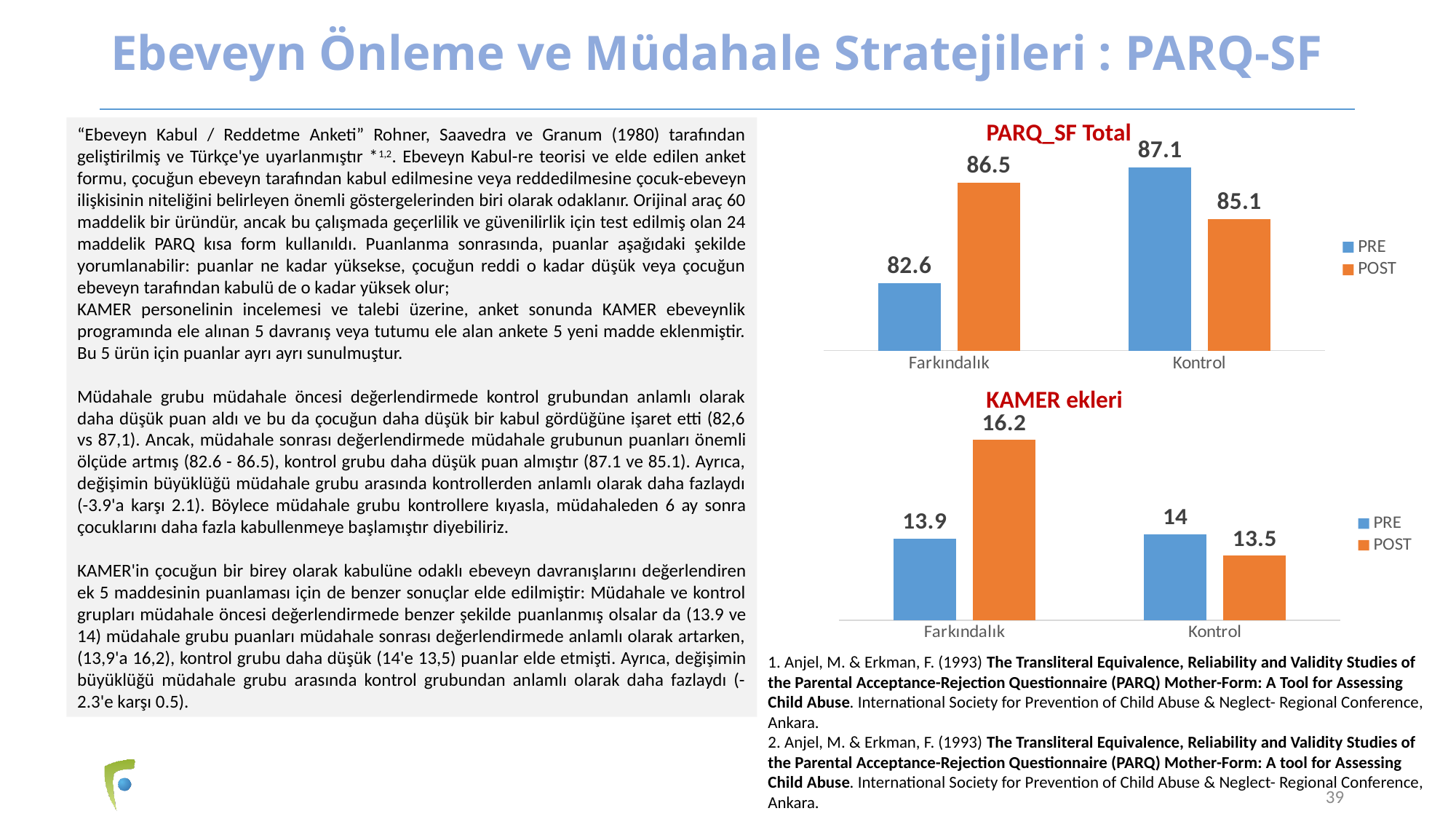
In the KAMER ekleri chart, what is the PRE value for Kontrol? 14 In the KAMER ekleri chart, what is the difference between the PRE and POST values for Kontrol? 0.5 How many categories are shown on the x axis of the PARQ_SF Total chart? 2 In the KAMER ekleri chart, what is the POST value for Farkındalık? 16.2 In the PARQ_SF Total chart, which bar is the highest? Kontrol PRE (87.1) In the PARQ_SF Total chart, what is the difference between the POST and PRE values for Farkındalık? 3.9 In the KAMER ekleri chart, which bar is the lowest? Kontrol POST (13.5) In the PARQ_SF Total chart, what is the POST value for Kontrol? 85.1 In the PARQ_SF Total chart, what is the PRE value for Farkındalık? 82.6 In the PARQ_SF Total chart, which is larger: the PRE value for Farkındalık or the PRE value for Kontrol? Kontrol What type of chart is the PARQ_SF Total chart? Bar chart How many series does the legend of the KAMER ekleri chart list? 2